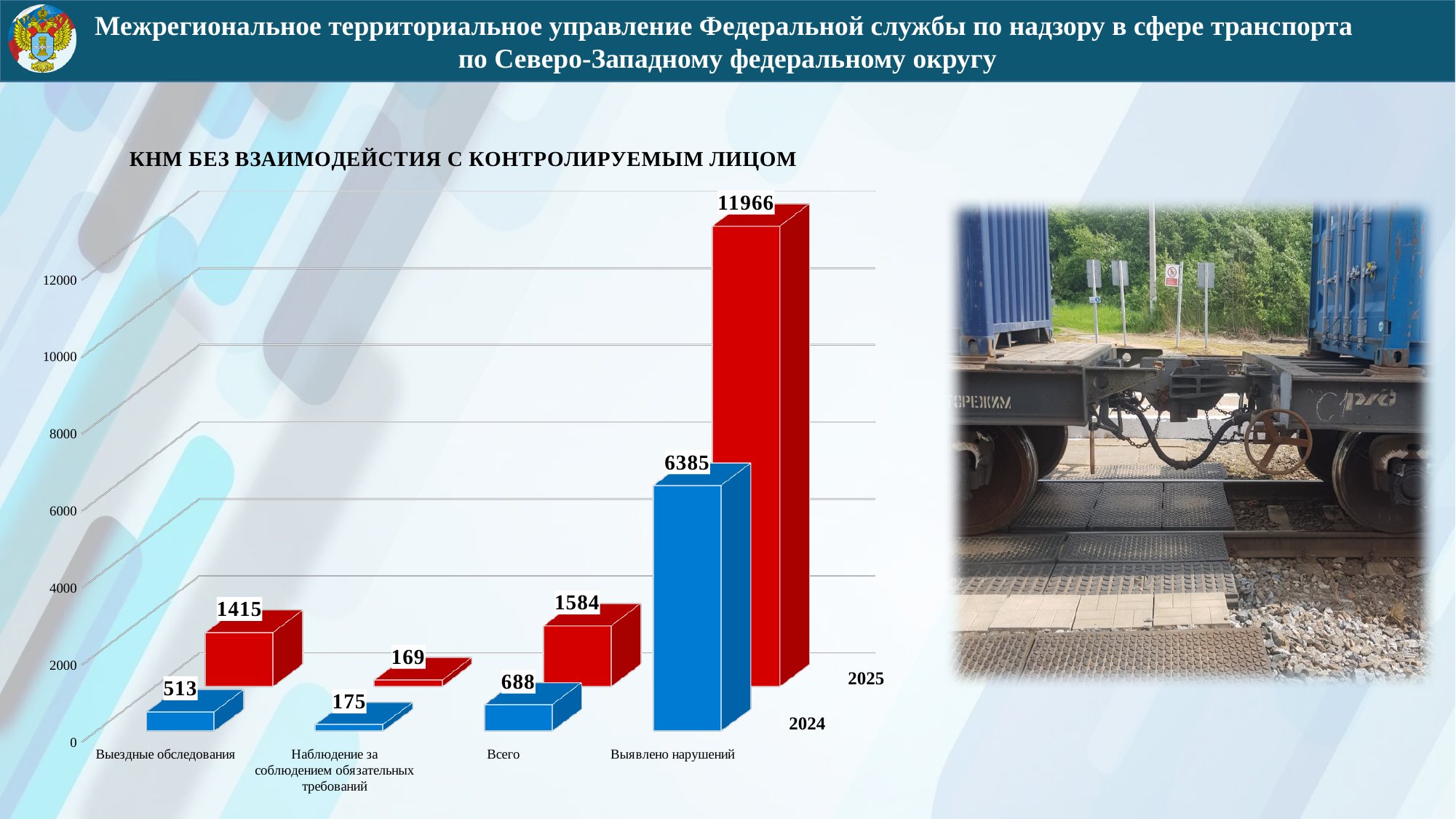
Which is larger for 'Выездные обследования': the 2024 value or the 2025 value? 2025 What is the value for 2025 in the category 'Наблюдение за соблюдением обязательных требований'? 169 How many categories are shown on the x axis of the chart? 4 What is the difference between the 2025 and 2024 values for 'Всего'? 896 Which category has the highest value for 2025? Выявлено нарушений What is the value for 2024 in the category 'Всего'? 688 What is the title of the chart? КНМ БЕЗ ВЗАИМОДЕЙСТИЯ С КОНТРОЛИРУЕМЫМ ЛИЦОМ What is the value for 2025 in the category 'Выездные обследования'? 1415 What is the difference between the 2025 and 2024 values for 'Выявлено нарушений'? 5581 What is the value for 2024 in the category 'Выявлено нарушений'? 6385 Which category has the lowest value for 2024? Наблюдение за соблюдением обязательных требований What type of chart is shown on the slide? Bar chart